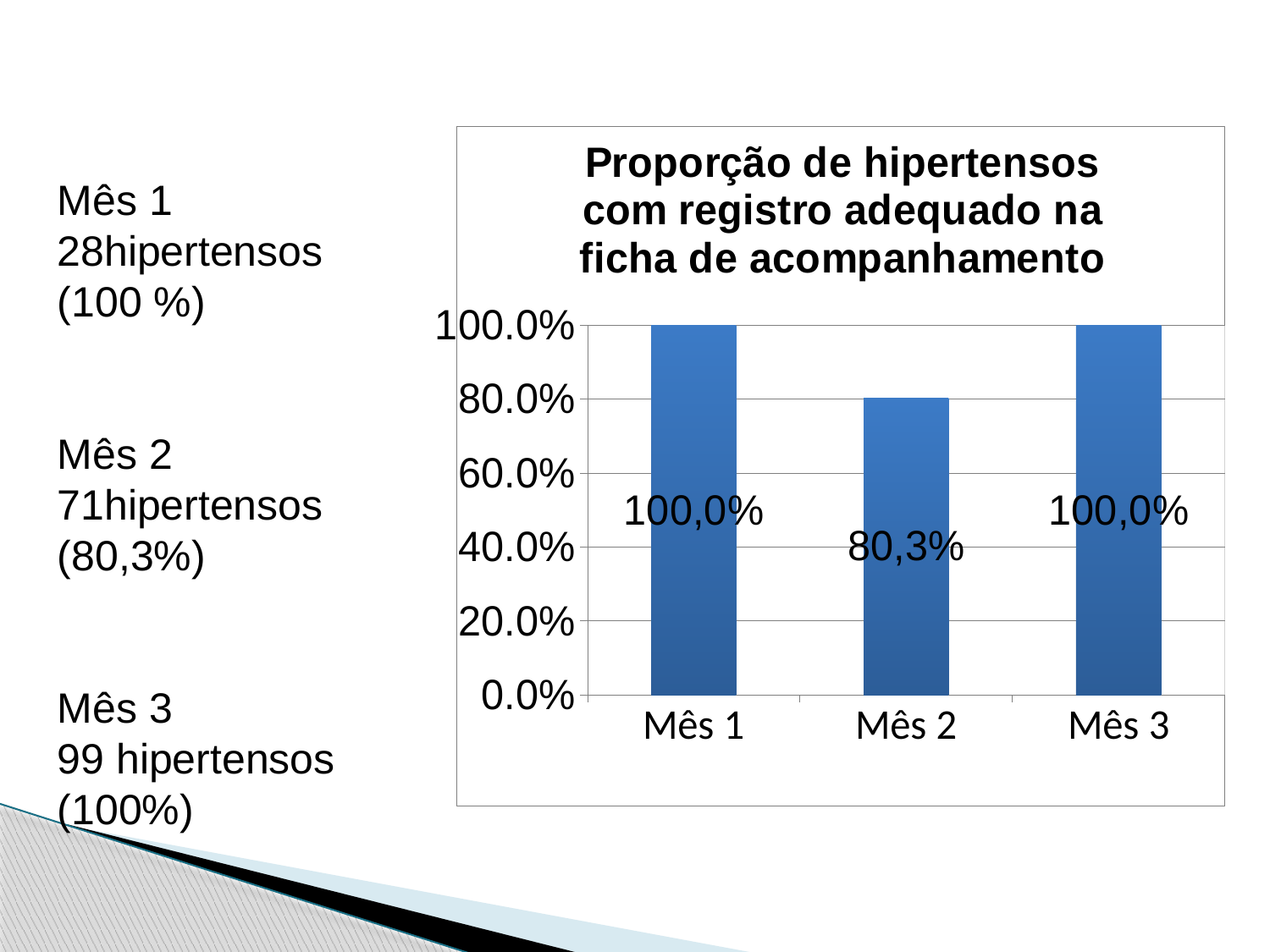
Which month has the lowest value? Mês 2 What is the value for Mês 1? 100,0% How many months are shown on the x axis? 3 Do the values for Mês 1 and Mês 3 differ? No What is the difference between the values for Mês 1 and Mês 2? 19,7% What kind of chart is this? bar chart What is the title of the chart? Proporção de hipertensos com registro adequado na ficha de acompanhamento Is the value for Mês 2 greater or less than 60.0%? greater Which is larger, the value for Mês 2 or the value for Mês 3? Mês 3 What is the highest value shown on the y axis? 100.0% What is the value for Mês 2? 80,3% What is the value for Mês 3? 100,0%